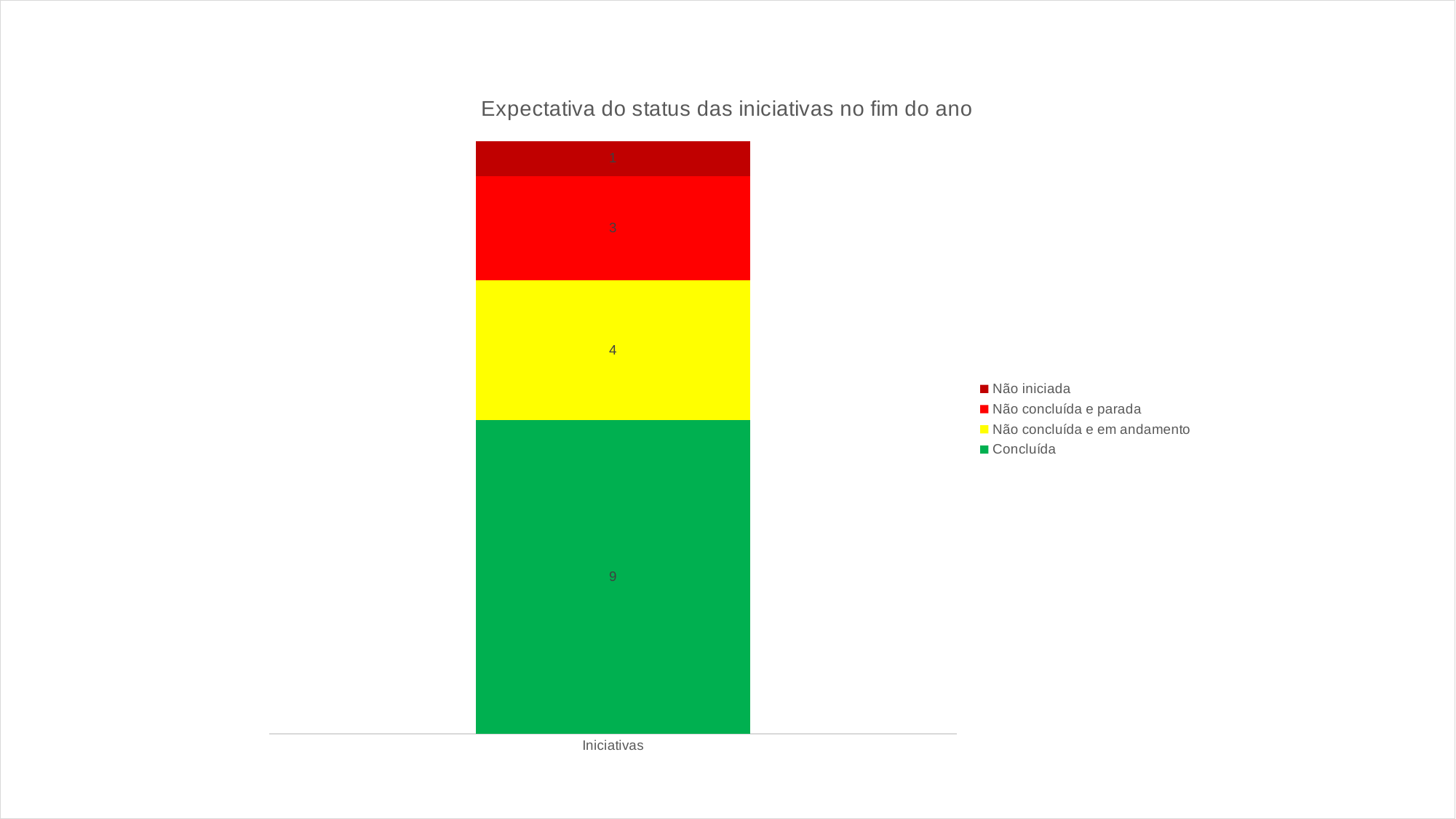
What is the value for Não concluída e em andamento? 4 How many series does the legend list? 4 What is the title of the chart? Expectativa do status das iniciativas no fim do ano What is the value for Concluída in the Iniciativas bar? 9 What is the value for Não iniciada? 1 What is the total of the stacked Iniciativas bar? 17 Which is larger, the value for Não concluída e parada or the value for Não concluída e em andamento? Não concluída e em andamento What is the difference between the Concluída value and the Não concluída e em andamento value? 5 Which series has the lowest value in the Iniciativas bar? Não iniciada What is the value for Não concluída e parada? 3 What kind of chart is shown on the slide? Stacked bar chart Which series has the highest value in the Iniciativas bar? Concluída